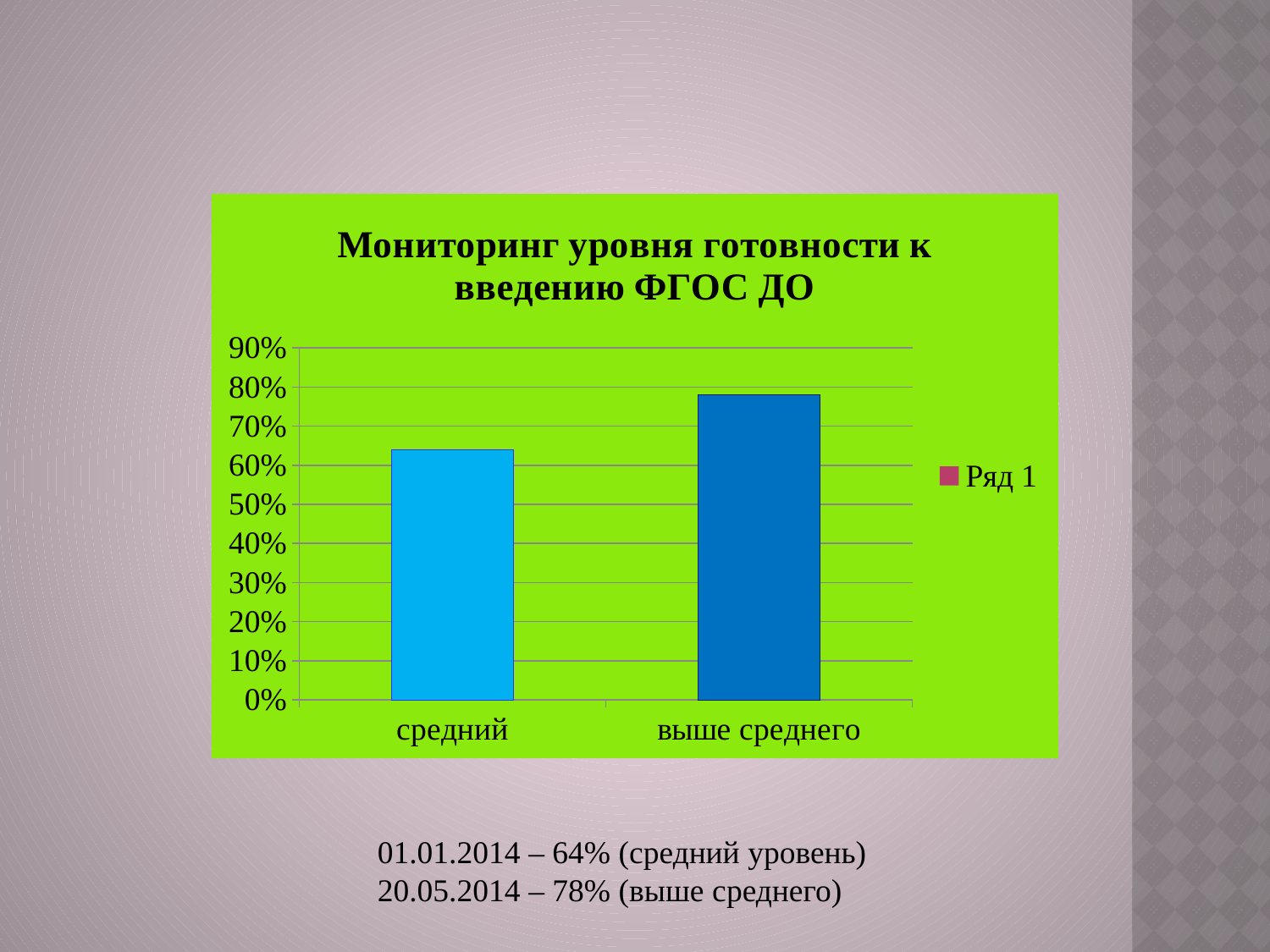
Which category has the lowest value? средний Is the value for 'средний' greater or less than 60%? greater Which is larger, the value for 'средний' or the value for 'выше среднего'? выше среднего How many series does the legend list? 1 Is the value for 'выше среднего' greater or less than 80%? less According to the slide, what is the value for 'выше среднего'? 78% Which category has the highest value? выше среднего What type of chart is shown on the slide? bar chart According to the slide, what is the value for 'средний'? 64% How many categories are shown on the x axis of the chart? 2 What is the name of the series in the legend? Ряд 1 What is the title of the chart? Мониторинг уровня готовности к введению ФГОС ДО